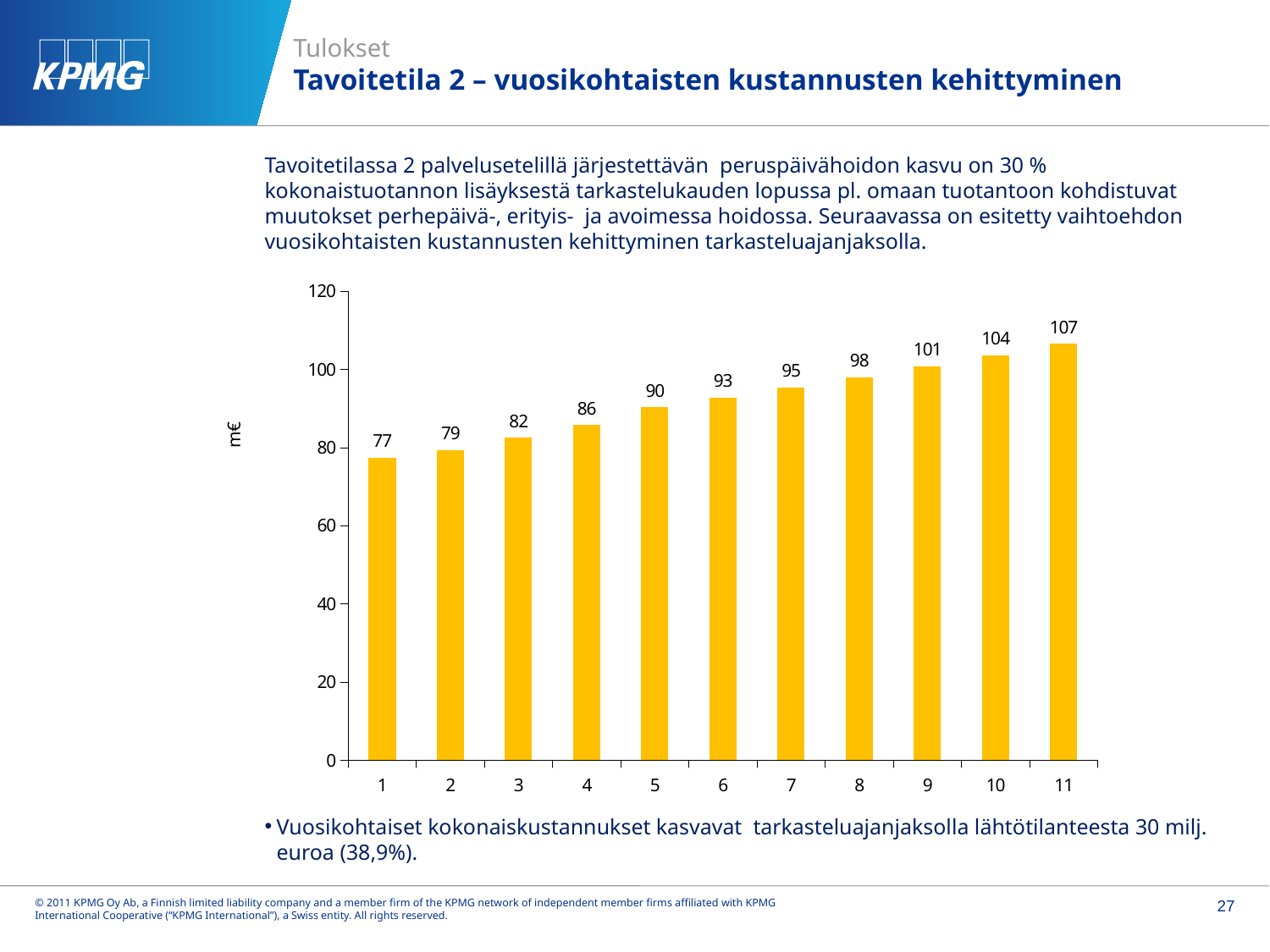
Which is larger, the value for category 4 or the value for category 8? category 8 Is the value for category 9 greater or less than 100? greater Do the values rise or fall from category 1 to category 11? rise How many categories are shown on the x axis? 11 What is the difference between the values for category 11 and category 1? 30 What is the value for category 11? 107 Which category has the lowest value? 1 What is the value for category 7? 95 What is the value for category 1? 77 Which category has the highest value? 11 What kind of chart is shown on the slide? bar chart What is the difference between the values for category 5 and category 3? 8